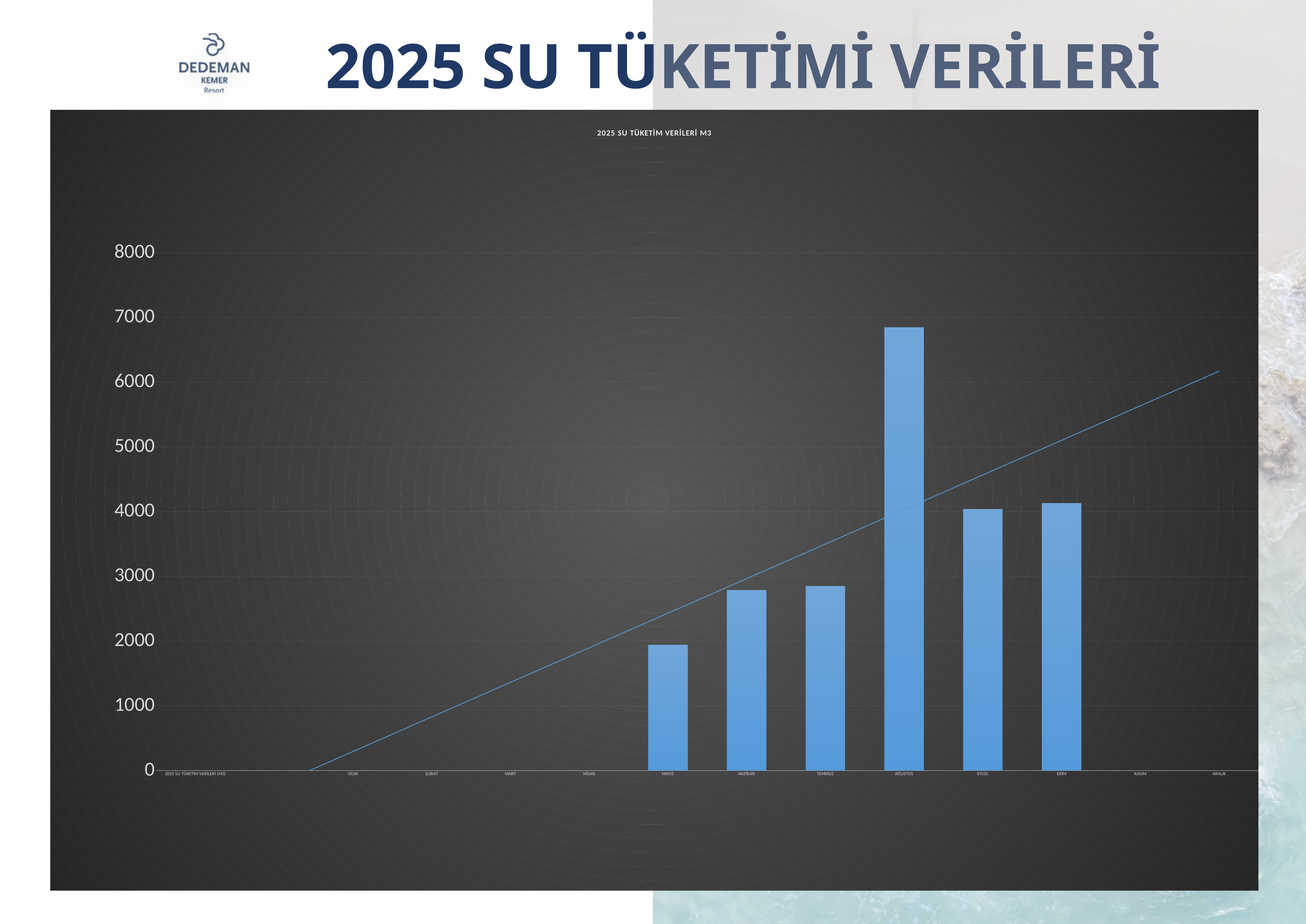
What kind of chart is shown on the slide? bar chart Is the value for AĞUSTOS greater or less than 6000? greater Which is larger, the value for AĞUSTOS or the value for EKİM? AĞUSTOS Which month has the highest bar in the chart? AĞUSTOS Is the value for EKİM greater or less than 5000? less How many months have a visible bar in the chart? 6 Is the value for MAYIS greater or less than 1000? greater Which is larger, the value for TEMMUZ or the value for MAYIS? TEMMUZ What is the title of the chart? 2025 SU TÜKETİM VERİLERİ M3 Among the months with a visible bar, which has the lowest value? MAYIS